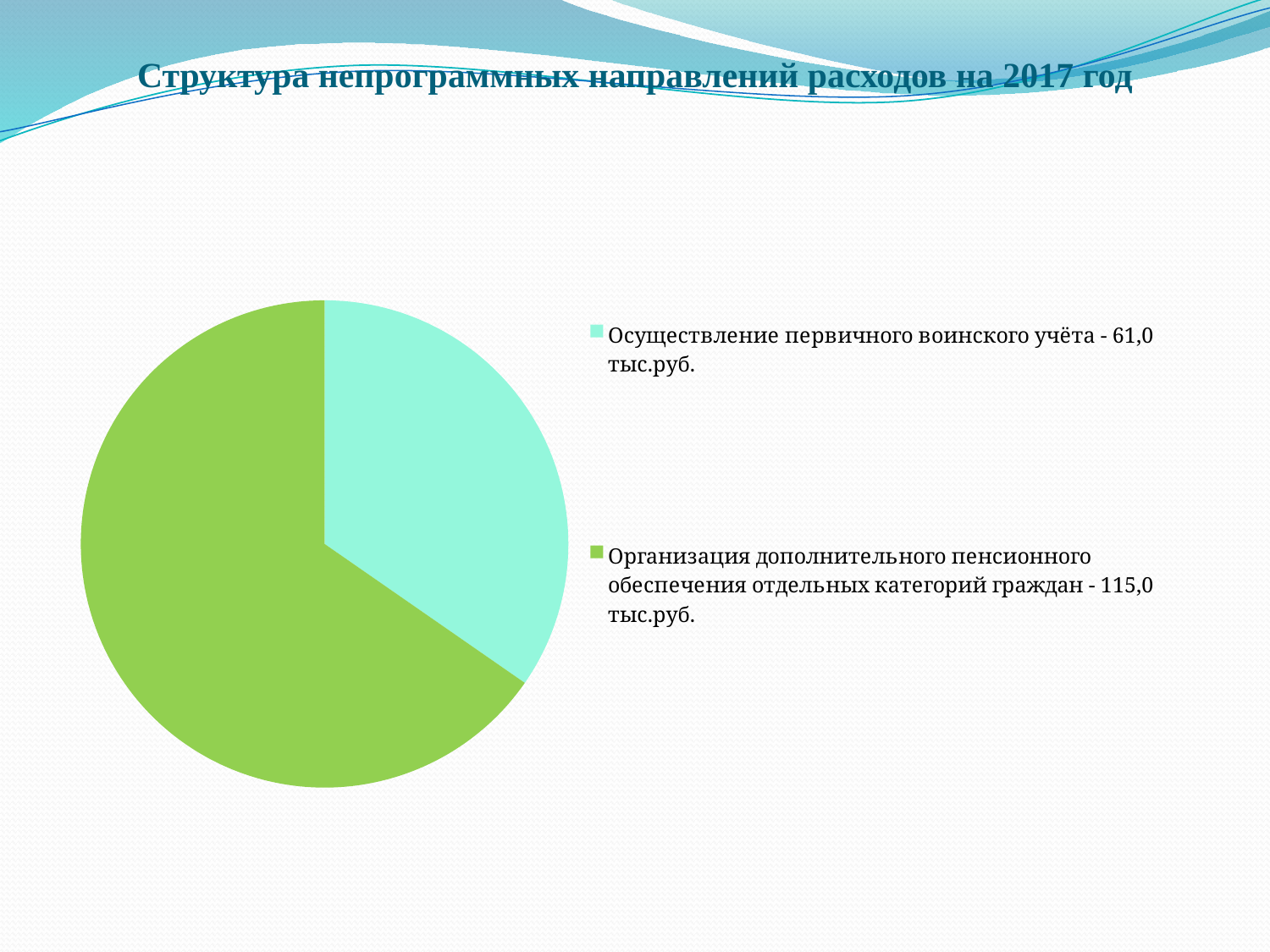
How many entries does the legend of the pie chart list? 2 What is the title of the slide containing the pie chart? Структура непрограммных направлений расходов на 2017 год Which category has the largest slice of the pie? Организация дополнительного пенсионного обеспечения отдельных категорий граждан What is the value for "Организация дополнительного пенсионного обеспечения отдельных категорий граждан"? 115,0 тыс.руб. Which category has the smallest slice of the pie? Осуществление первичного воинского учёта Which is larger: the value for "Осуществление первичного воинского учёта" or the value for "Организация дополнительного пенсионного обеспечения отдельных категорий граждан"? Организация дополнительного пенсионного обеспечения отдельных категорий граждан What kind of chart is shown on the slide? Pie chart What is the value for "Осуществление первичного воинского учёта"? 61,0 тыс.руб. What colour is the slice for "Осуществление первичного воинского учёта"? Light turquoise How many slices does the pie chart have? 2 What is the total of the two values shown in the pie chart? 176,0 тыс.руб. What is the difference between the value for "Организация дополнительного пенсионного обеспечения отдельных категорий граждан" and the value for "Осуществление первичного воинского учёта"? 54,0 тыс.руб.